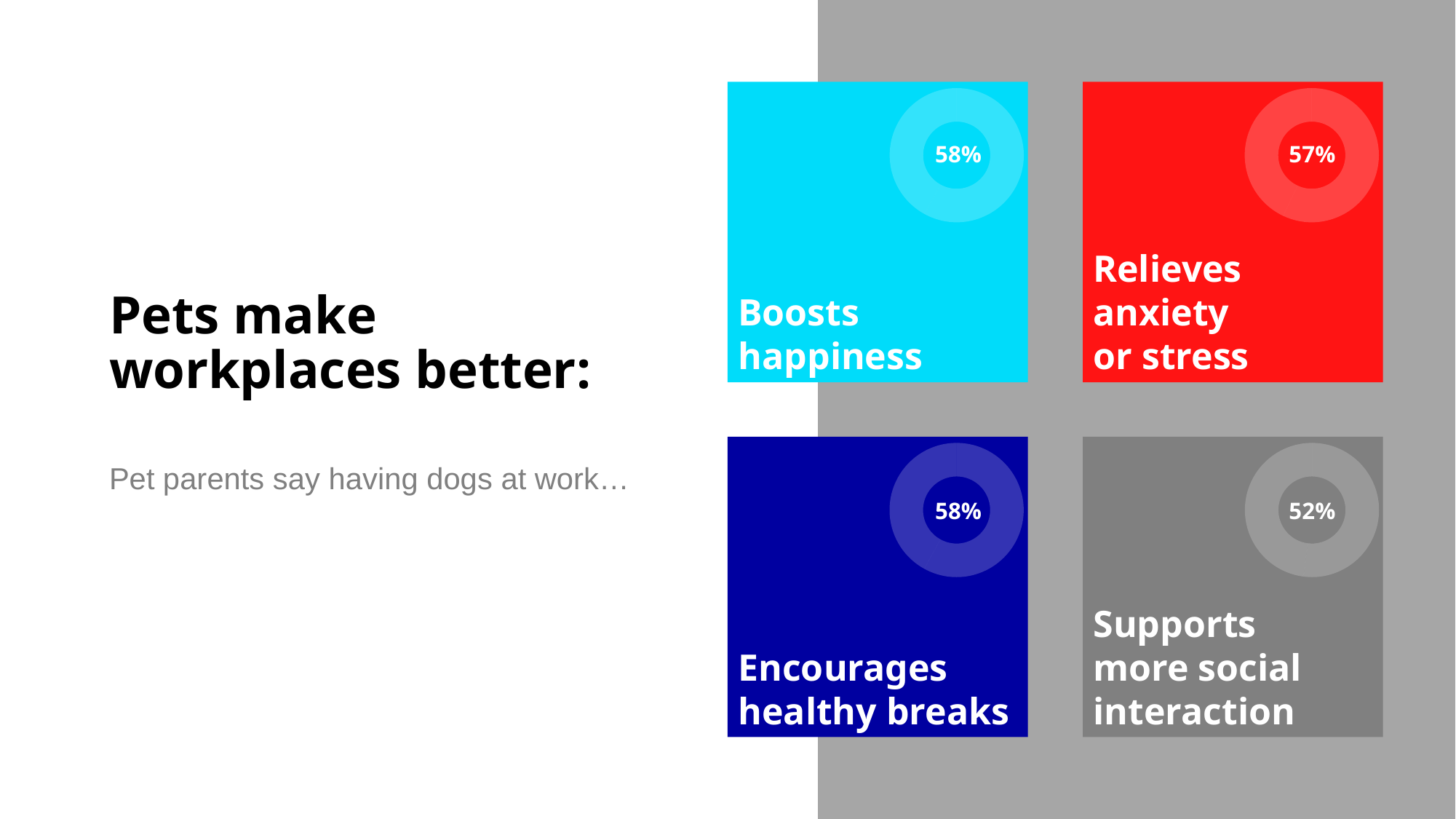
Which of the four benefits has the lowest percentage? Supports more social interaction What colour is the tile for 'Relieves anxiety or stress'? Red Which is larger: the percentage for 'Boosts happiness' or for 'Supports more social interaction'? Boosts happiness What is the difference in percentage points between 'Boosts happiness' and 'Supports more social interaction'? 6 percentage points What is the difference in percentage points between 'Relieves anxiety or stress' and 'Supports more social interaction'? 5 percentage points What percentage is shown in the 'Relieves anxiety or stress' chart? 57% What kind of chart is used in each of the four tiles? Doughnut chart What percentage is shown in the 'Encourages healthy breaks' chart? 58% Which is larger: the percentage for 'Encourages healthy breaks' or for 'Relieves anxiety or stress'? Encourages healthy breaks What percentage is shown in the 'Boosts happiness' chart? 58% How many benefit charts are shown on the slide? 4 What percentage is shown in the 'Supports more social interaction' chart? 52%